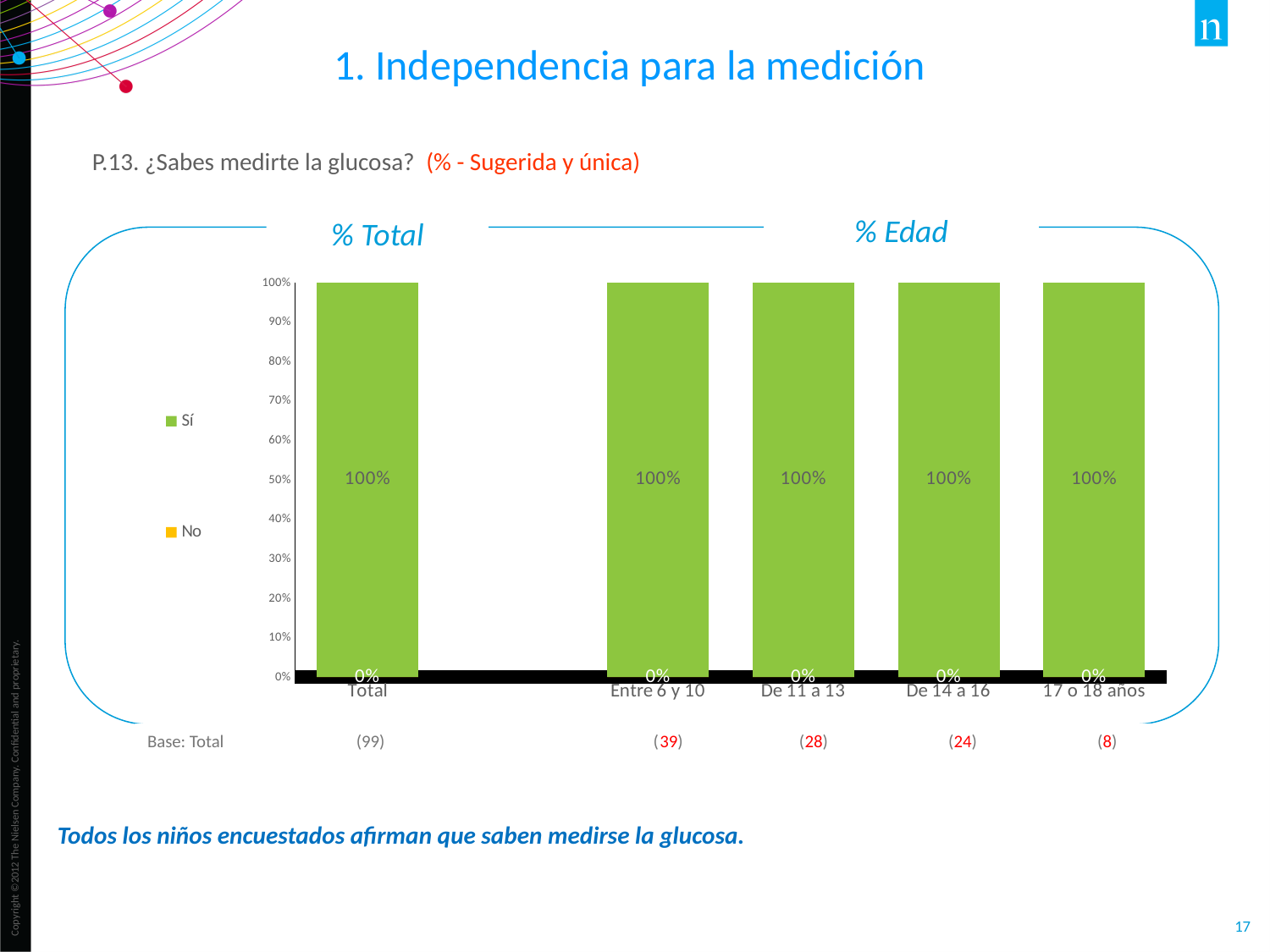
How many series does the chart legend list? 2 What is the total of the stacked bar for the "Entre 6 y 10" category? 100% How many categories are shown on the x axis of the chart? 5 What is the value of "Sí" for the "17 o 18 años" category? 100% What is the value of "No" for the "De 11 a 13" category? 0% What kind of chart is shown on the slide? Stacked bar chart What is the base (number of respondents) shown for the "De 14 a 16" category? (24) What is the value of "Sí" for the "De 14 a 16" category? 100% Which series is shown in green in the chart legend? Sí What is the value of "No" for the "Entre 6 y 10" category? 0% What is the value of "Sí" for the "Total" category? 100% What is the difference between the "Sí" and "No" values for the "De 11 a 13" category? 100%